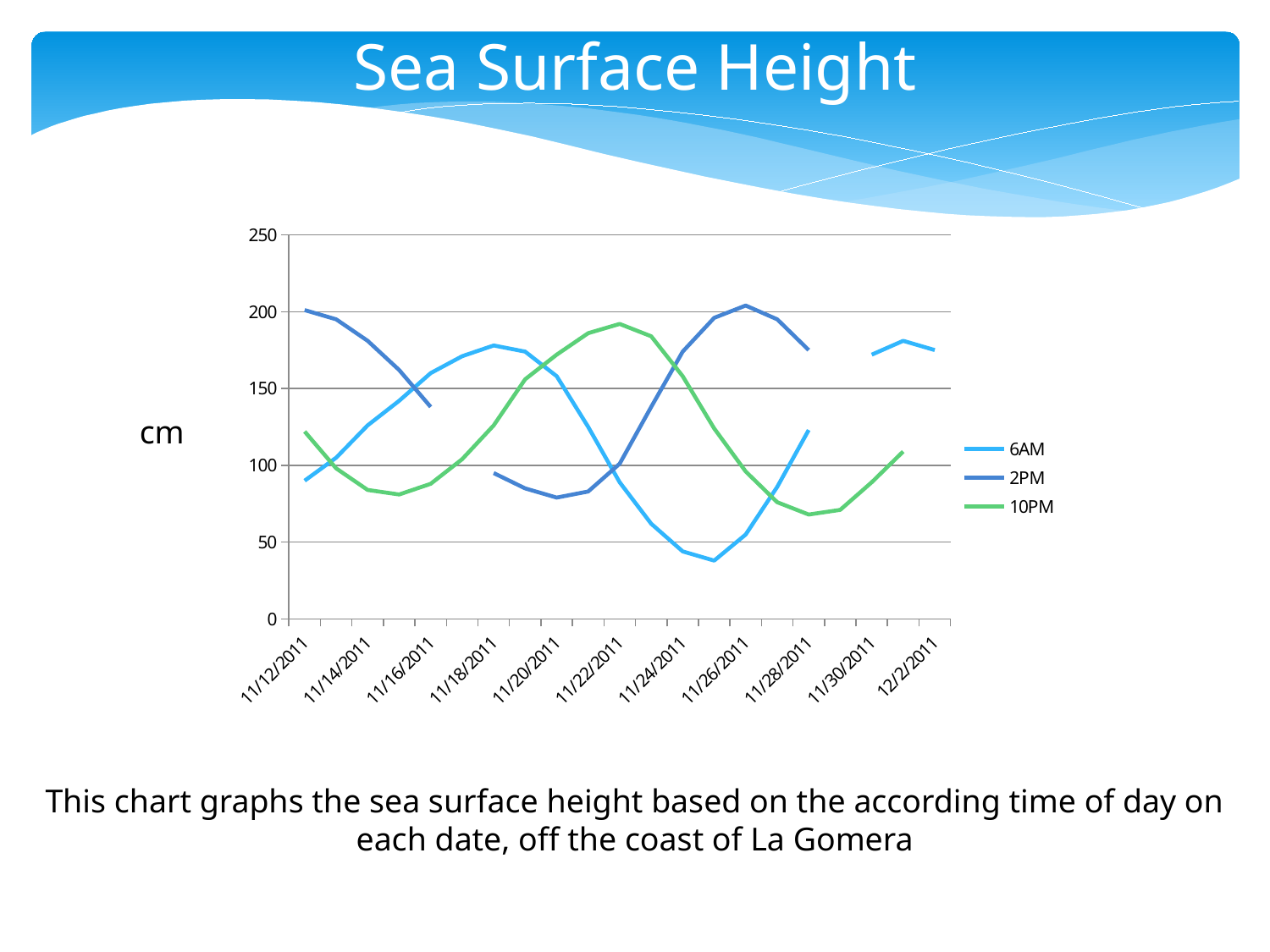
What unit is shown as the label of the vertical axis? cm Does the 6AM series rise or fall from 11/12/2011 to 11/18/2011? rise What is the title of the chart? Sea Surface Height How many dates are labeled on the x axis? 11 How many series does the legend list? 3 Is the 2PM value on 11/26/2011 greater or less than 150? greater Does the 2PM series rise or fall from 11/12/2011 to 11/16/2011? fall Is the 2PM value on 11/20/2011 greater or less than 100? less What kind of chart is shown on the slide? line chart Is the 10PM value on 11/22/2011 greater or less than 150? greater